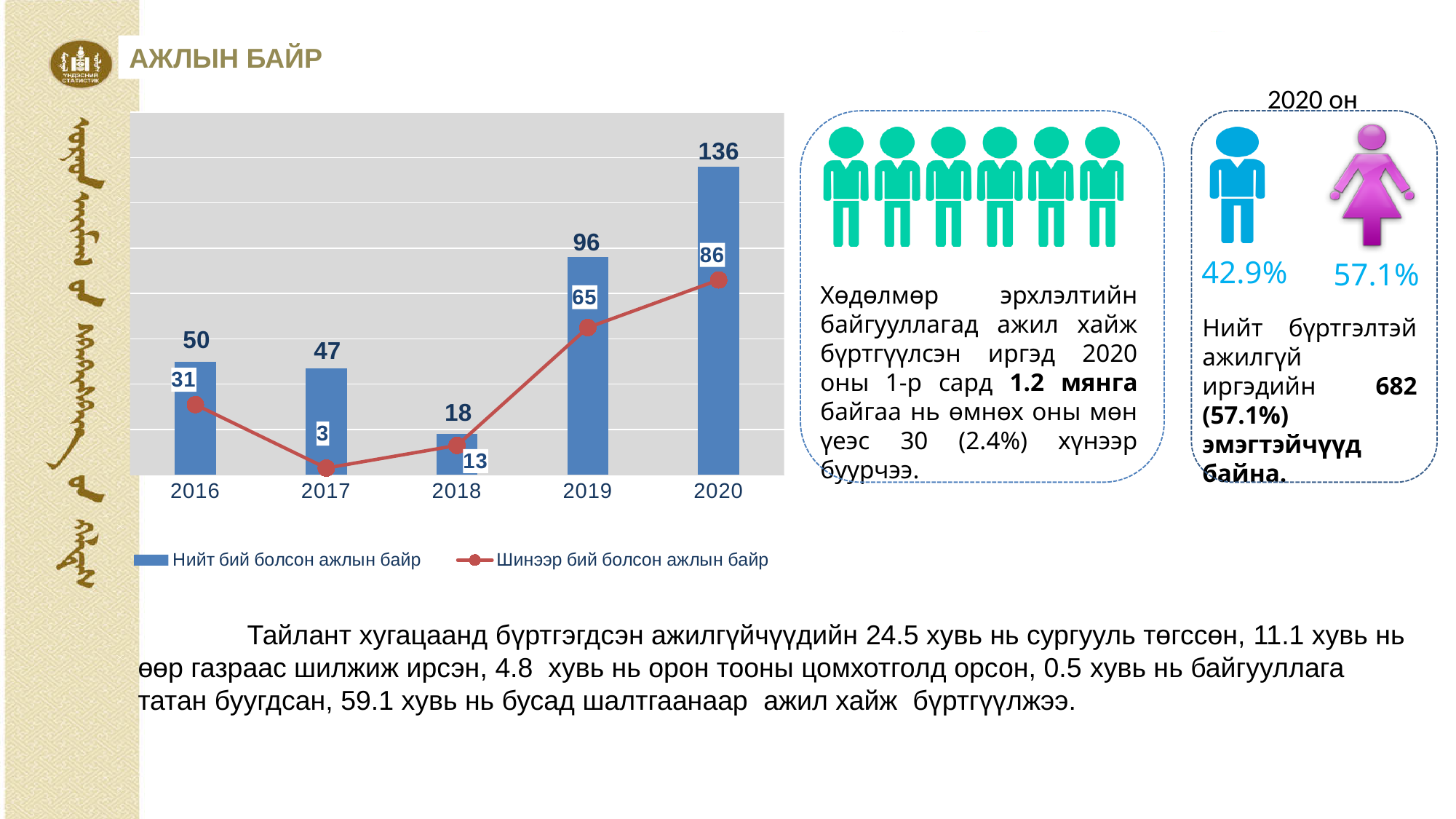
What is the difference between the bar value and the line value for 2019? 31 How many years are shown on the x axis of the chart? 5 What is the value of the bar series (Нийт бий болсон ажлын байр) for 2020? 136 What is the value of the bar series (Нийт бий болсон ажлын байр) for 2018? 18 Which year has the highest value for the bar series (Нийт бий болсон ажлын байр)? 2020 Which year has the lowest value for the line series (Шинээр бий болсон ажлын байр)? 2017 How many series does the chart legend list? 2 Which is larger: the bar value for 2016 or the bar value for 2017? 2016 What kind of chart is shown on the slide? Combined bar and line chart What is the value of the line series (Шинээр бий болсон ажлын байр) for 2017? 3 Do the values of the line series (Шинээр бий болсон ажлын байр) rise or fall from 2018 to 2020? Rise What colour are the bars in the chart? Blue